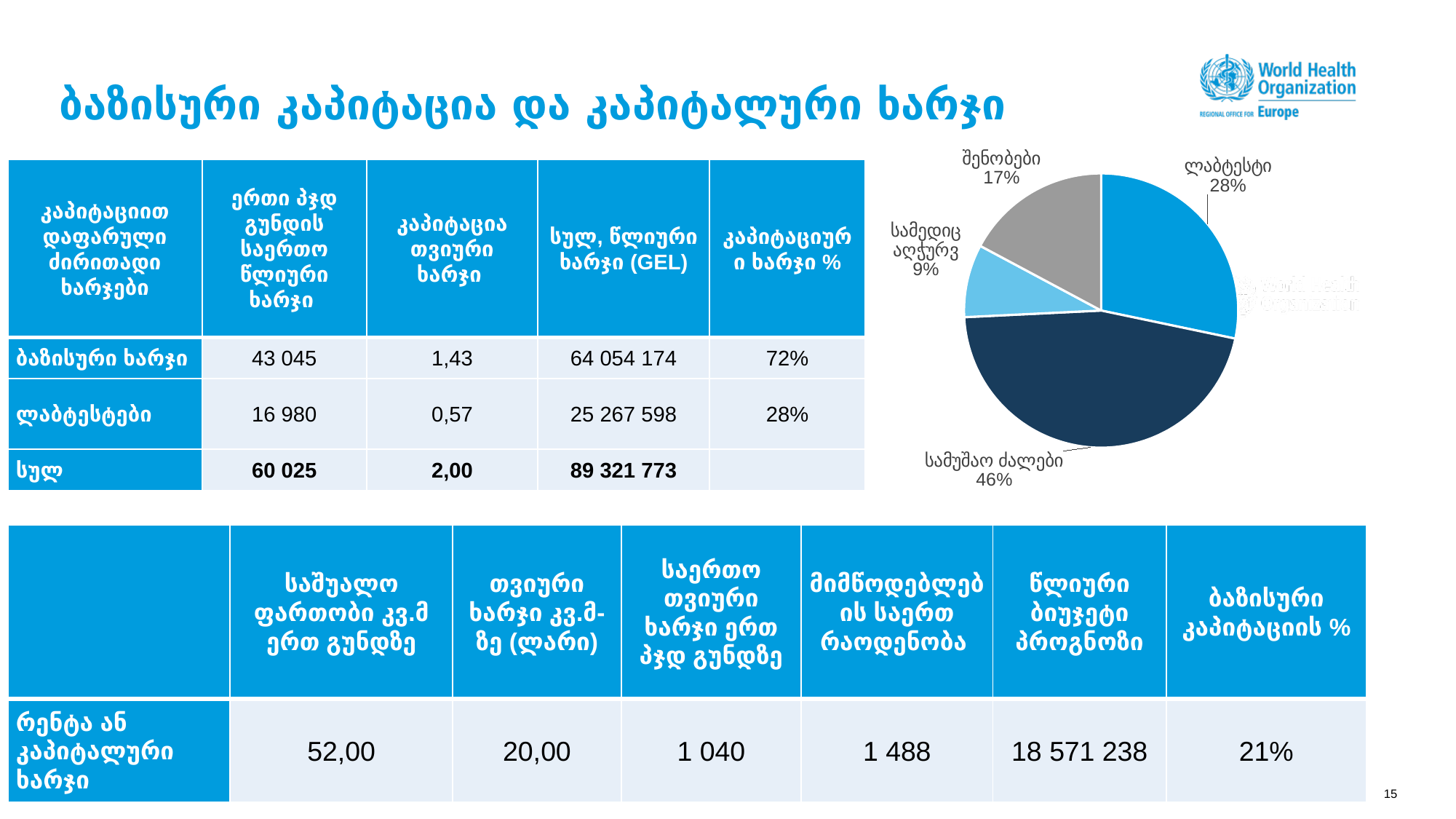
What share of the pie chart is labelled ლაბტესტი? 28% What kind of chart is shown on the right side of the slide? pie chart In the pie chart, which is larger: ლაბტესტი or შენობები? ლაბტესტი In the pie chart, what is the difference in percentage points between სამუშაო ძალები and ლაბტესტი? 18 What colour is the სამუშაო ძალები slice in the pie chart? dark navy blue Which slice of the pie chart is the largest? სამუშაო ძალები Which slice of the pie chart is the smallest? სამედიც აღჭურვ What share of the pie chart is labelled სამედიც აღჭურვ? 9% How many slices does the pie chart have? 4 What share of the pie chart is labelled შენობები? 17% In the pie chart, what is the difference in percentage points between შენობები and სამედიც აღჭურვ? 8